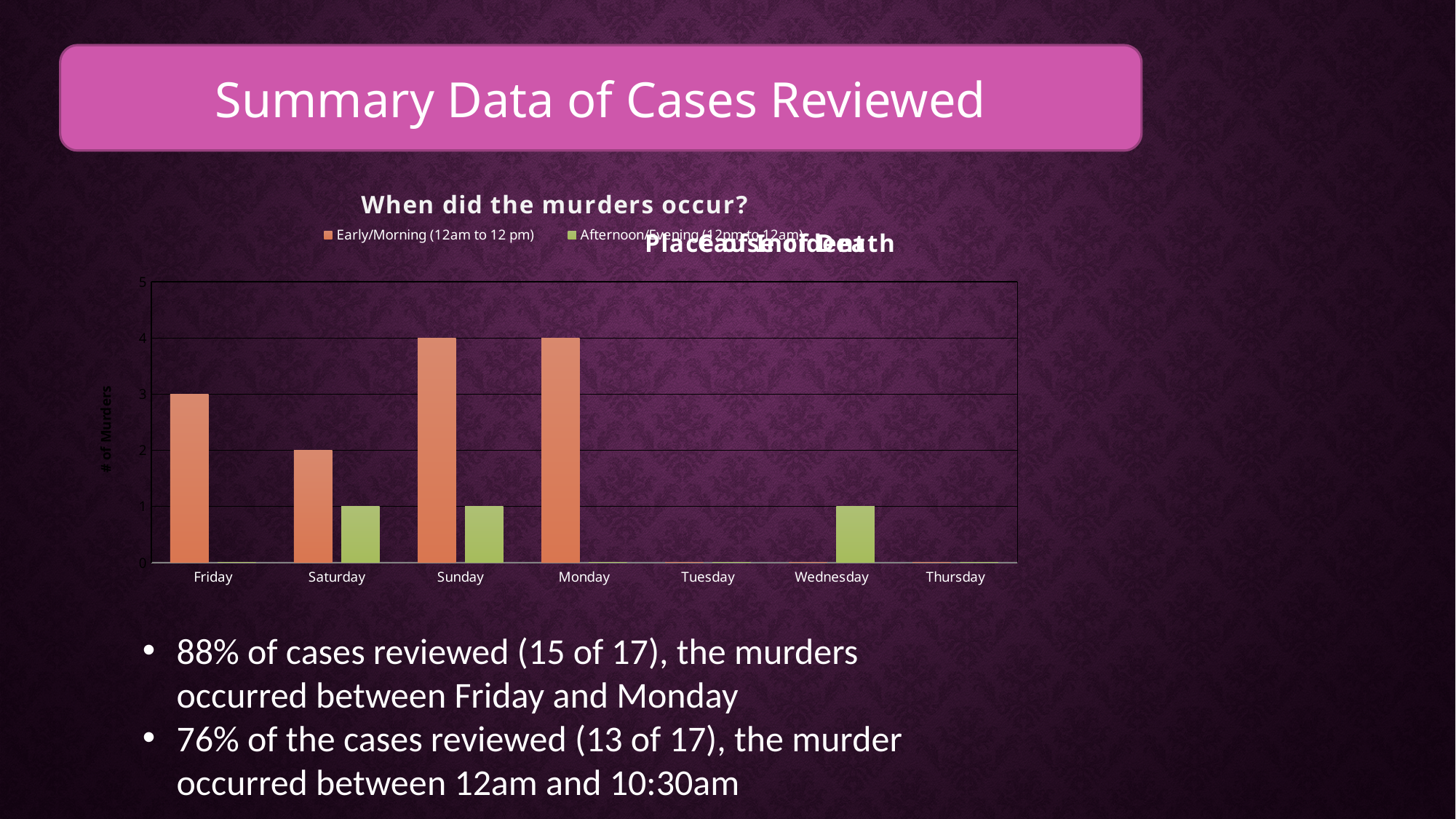
How many murders occurred on Sunday in the Afternoon/Evening (12pm to 12am) period? 1 How many series does the chart legend list? 2 Which day has more Early/Morning murders, Friday or Saturday? Friday How many murders occurred on Monday in the Early/Morning (12am to 12 pm) period? 4 How many days are shown on the x axis of the chart? 7 How many murders occurred on Friday in the Early/Morning (12am to 12 pm) period? 3 Is the Early/Morning value for Friday greater or less than 2? greater What type of chart is shown on the slide? bar chart How many murders occurred on Saturday in the Early/Morning (12am to 12 pm) period? 2 What is the difference between the Early/Morning murders on Sunday and on Saturday? 2 Which colour represents the Afternoon/Evening (12pm to 12am) series in the chart? green What is the title of the chart? When did the murders occur?